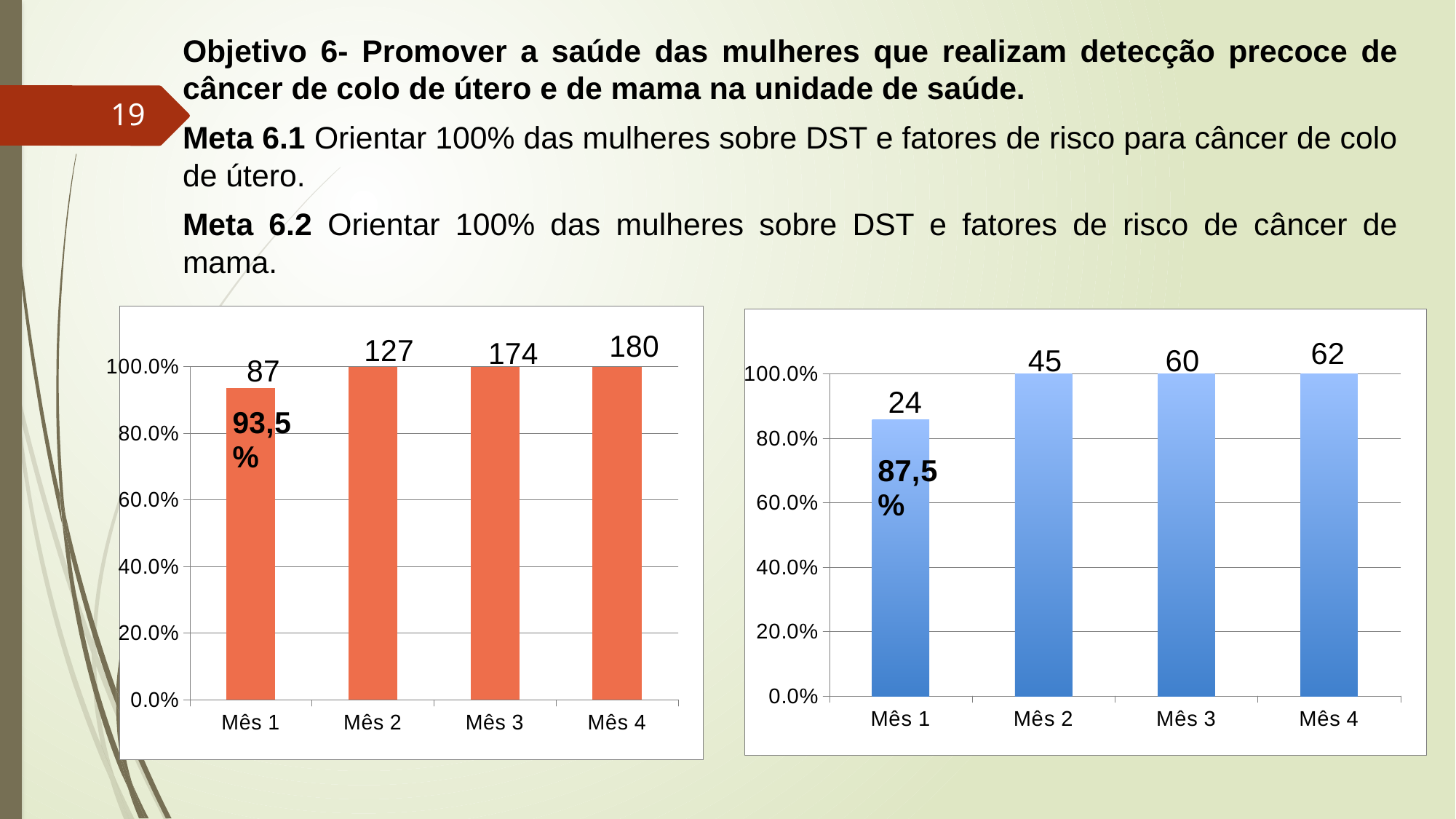
In the left chart with orange bars, which month has the lowest bar? Mês 1 In the left chart with orange bars, what percentage is printed on the bar for Mês 1? 93,5% What kind of chart is the right chart with blue bars? bar chart In the right chart with blue bars, what data label is shown above the bar for Mês 2? 45 In the right chart with blue bars, which month has the lowest bar? Mês 1 In the left chart with orange bars, what data label is shown above the bar for Mês 4? 180 In the right chart with blue bars, what is the difference between the data labels for Mês 3 and Mês 2? 15 In the right chart with blue bars, what percentage is printed on the bar for Mês 1? 87,5% In the right chart with blue bars, is the bar for Mês 1 greater or less than 80.0%? greater In the left chart with orange bars, is the data label for Mês 3 larger or smaller than the data label for Mês 2? larger In the left chart with orange bars, what is the difference between the data labels for Mês 4 and Mês 1? 93 How many months are shown on the x axis of the left chart with orange bars? 4